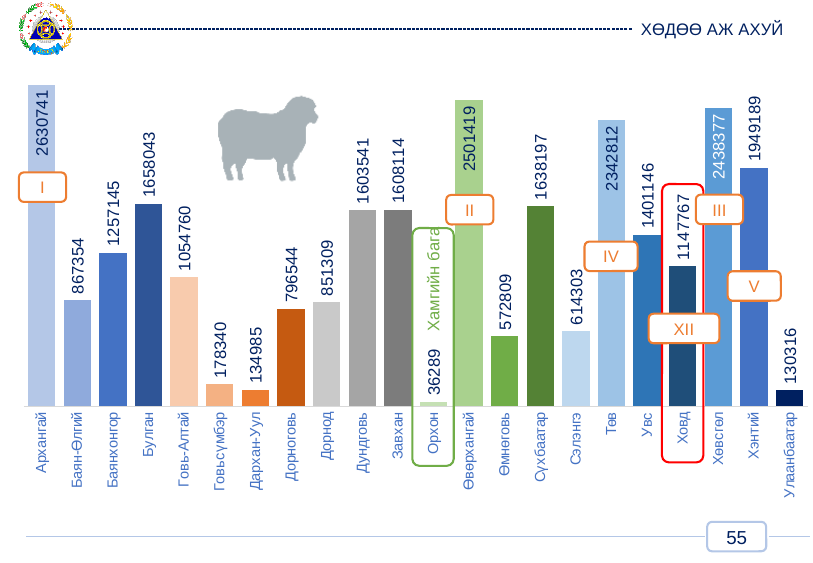
What is the value shown for Улаанбаатар? 130316 Which is larger, the value for Хэнтий or the value for Увс? Хэнтий What is the difference between the values for Архангай and Өвөрхангай? 129322 What is the value shown for Орхон? 36289 What is the value shown for Хөвсгөл? 2438377 What is the value shown for Архангай? 2630741 Which category has the lowest value? Орхон What kind of chart is shown on the slide? bar chart Which category has the highest value? Архангай How many categories are shown on the x axis? 22 What is the difference between the values for Хөвсгөл and Төв? 95565 Which category is marked with the rank label "I"? Архангай